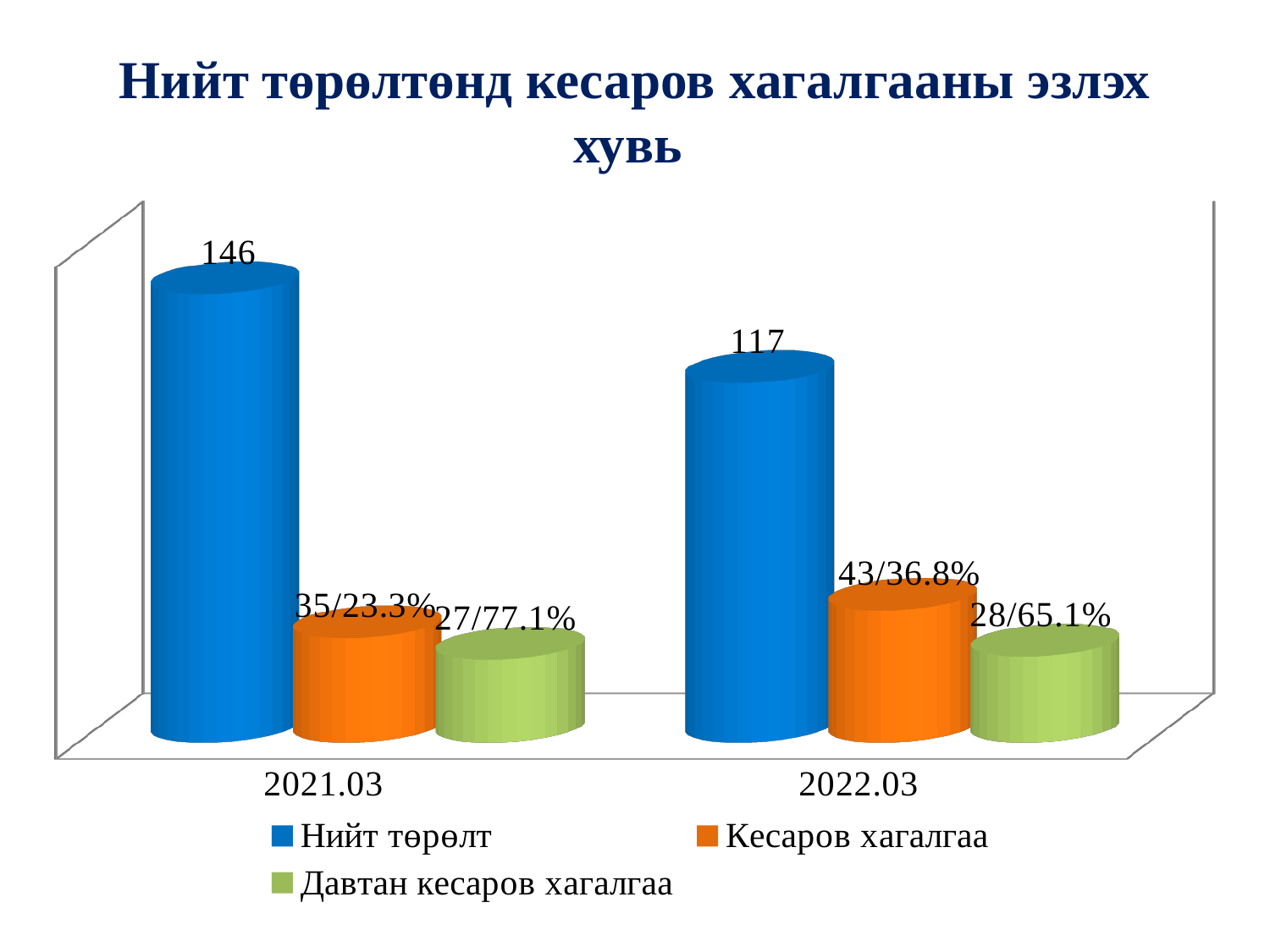
What is the value for Нийт төрөлт in 2021.03? 146 What data label is shown for Давтан кесаров хагалгаа in 2022.03? 28/65.1% What kind of chart is shown on the slide? Bar chart How many series does the legend list? 3 What is the value for Нийт төрөлт in 2022.03? 117 What is the difference in Нийт төрөлт between 2021.03 and 2022.03? 29 What data label is shown for Кесаров хагалгаа in 2021.03? 35/23.3% Which is larger: Нийт төрөлт in 2021.03 or in 2022.03? 2021.03 What data label is shown for Кесаров хагалгаа in 2022.03? 43/36.8% How many categories are shown on the x axis? 2 In which period is Нийт төрөлт highest? 2021.03 What data label is shown for Давтан кесаров хагалгаа in 2021.03? 27/77.1%